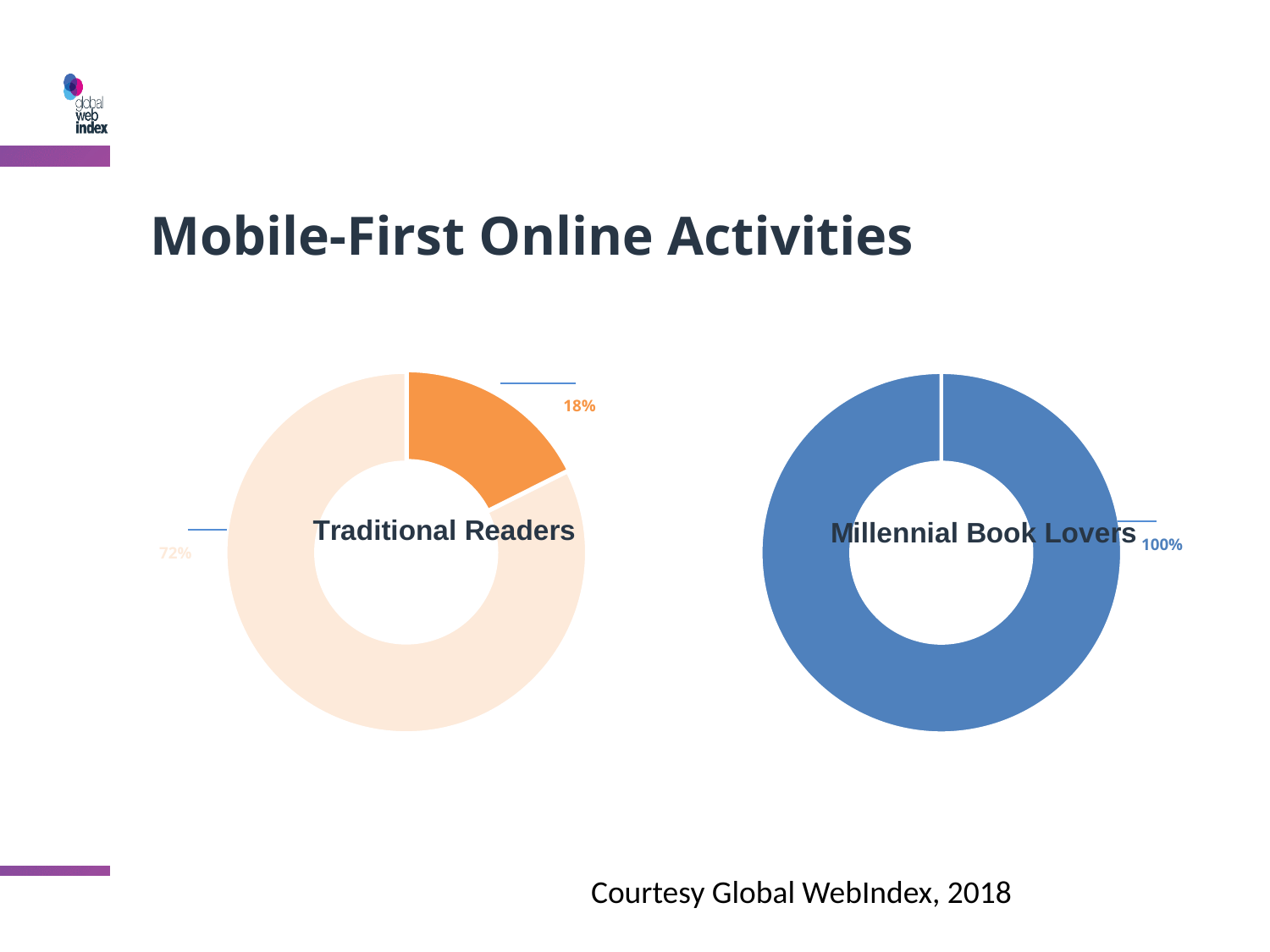
What source is credited below the charts? Global WebIndex, 2018 What is the title of the slide containing the two doughnut charts? Mobile-First Online Activities In the Traditional Readers chart, what value is labelled on the light peach slice? 72% In the Traditional Readers chart, what value is labelled on the dark orange slice? 18% In the Traditional Readers chart, which slice is the largest? The light peach slice (72%) In the Traditional Readers chart, what is the difference between the 72% slice and the 18% slice? 54 percentage points What kind of chart is the Traditional Readers chart? Doughnut chart How many doughnut charts are shown on the slide? 2 In the Millennial Book Lovers chart, what value is labelled on the blue ring? 100% How many slices does the Traditional Readers chart have? 2 Which is larger: the Millennial Book Lovers value or the dark orange slice of the Traditional Readers chart? Millennial Book Lovers (100%) In the Traditional Readers chart, which slice is larger, the dark orange one or the light peach one? The light peach one (72%)